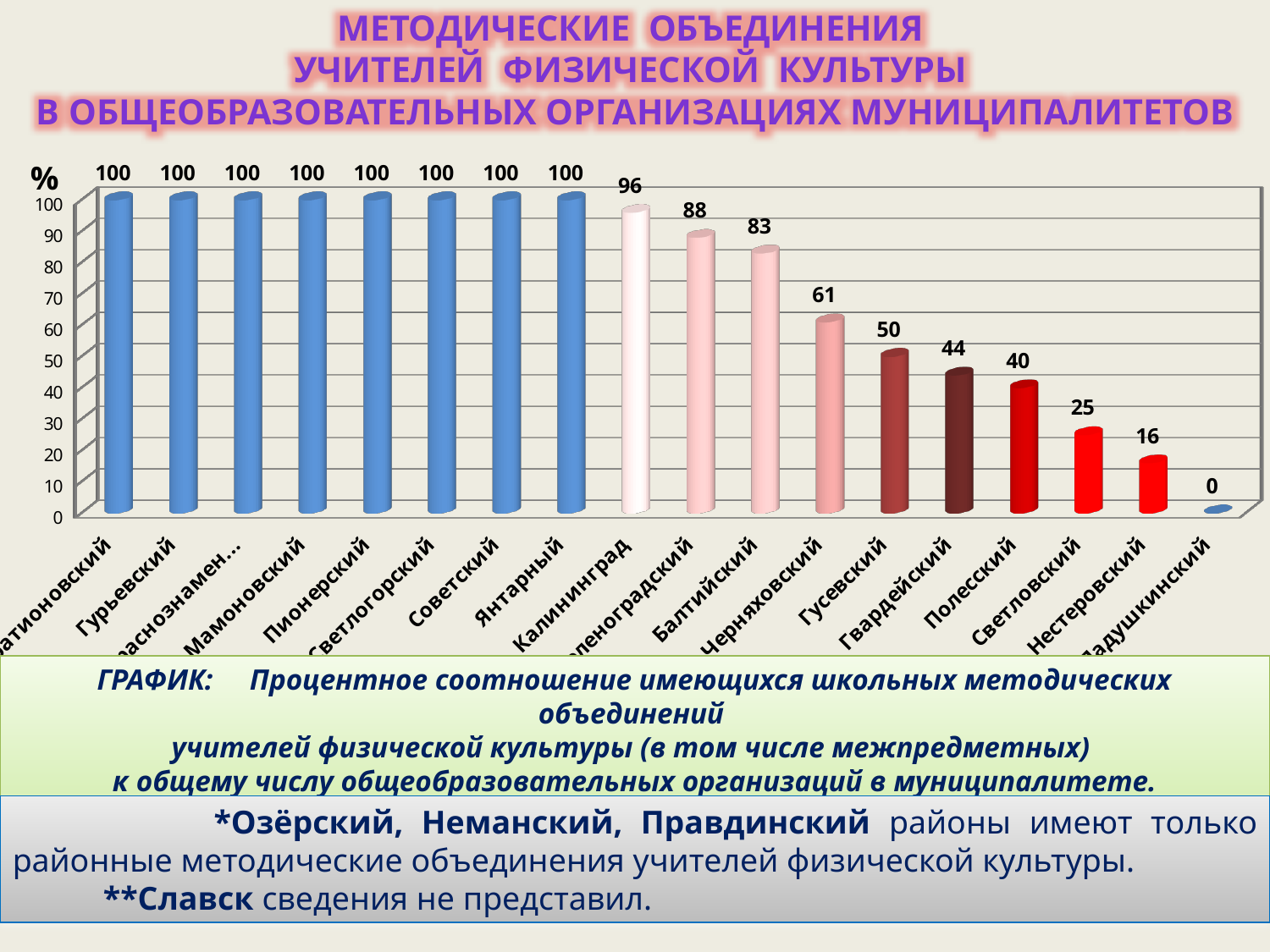
What kind of chart is shown on the slide? bar chart What is the value for Балтийский? 83 What is the value for Нестеровский? 16 What is the value for Светловский? 25 What is the difference between the values for Калининград and Черняховский? 35 What is the difference between the values for Гурьевский and Светловский? 75 What is the value for Калининград? 96 What unit is indicated at the top of the vertical axis? % What is the value for Гусевский? 50 How many categories (municipalities) are shown on the chart? 18 Do the values rise or fall moving from left to right along the x axis? fall Which has a larger value, Гвардейский or Полесский? Гвардейский